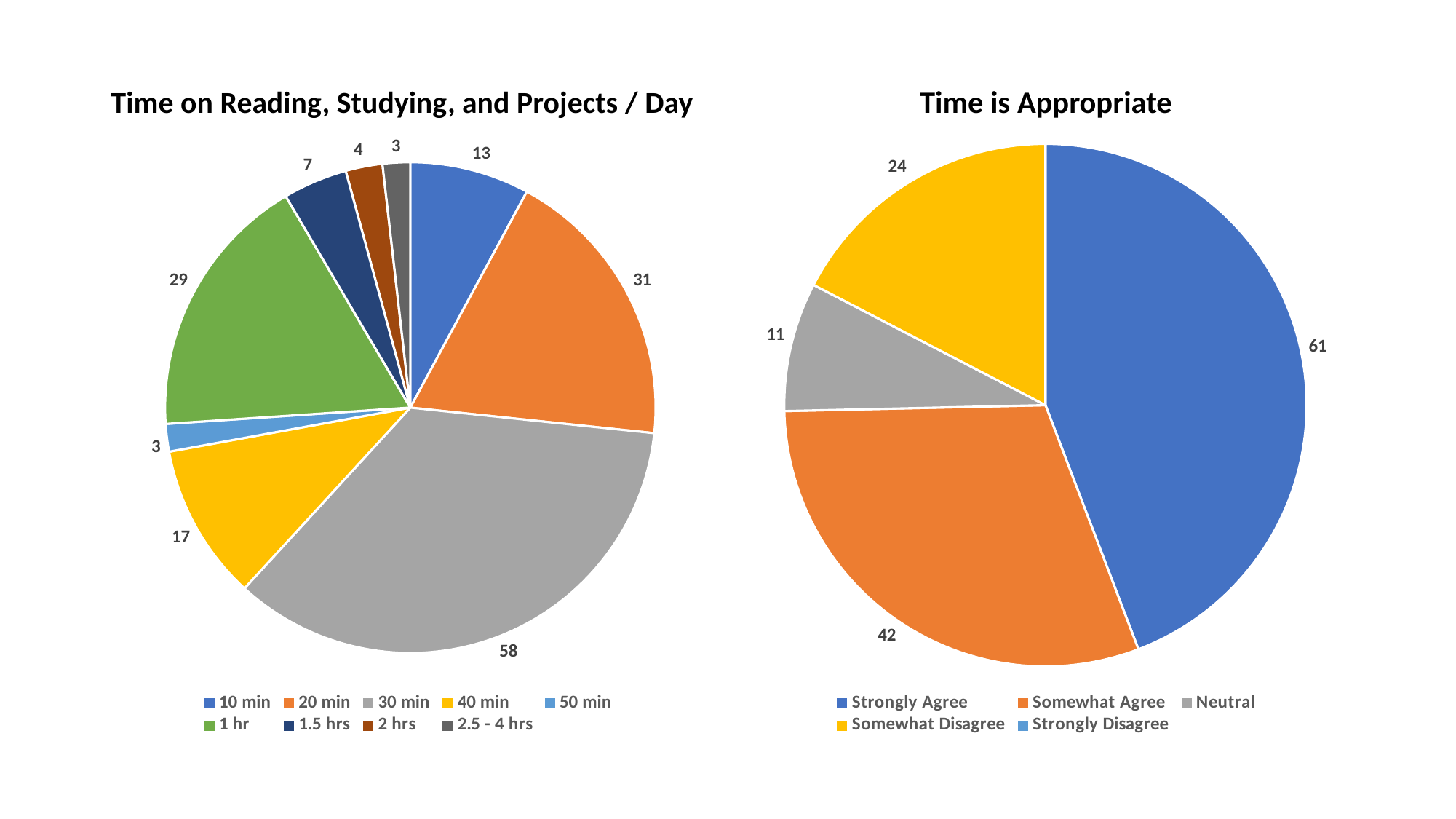
How many legend entries does the 'Time is Appropriate' chart list? 5 In the 'Time on Reading, Studying, and Projects / Day' chart, what is the value for 1 hr? 29 What kind of chart is 'Time on Reading, Studying, and Projects / Day'? Pie chart In the 'Time is Appropriate' chart, which category has the largest slice? Strongly Agree In the 'Time on Reading, Studying, and Projects / Day' chart, what is the difference between the values for 20 min and 10 min? 18 In the 'Time is Appropriate' chart, what is the difference between Strongly Agree and Somewhat Disagree? 37 In the 'Time is Appropriate' chart, which labelled category has the smallest slice? Neutral In the 'Time is Appropriate' chart, what is the value for Somewhat Agree? 42 In the 'Time on Reading, Studying, and Projects / Day' chart, what is the value for 30 min? 58 In the 'Time on Reading, Studying, and Projects / Day' chart, which is larger: 40 min or 1 hr? 1 hr In the 'Time is Appropriate' chart, what is the value for Neutral? 11 In the 'Time on Reading, Studying, and Projects / Day' chart, which category has the highest value? 30 min